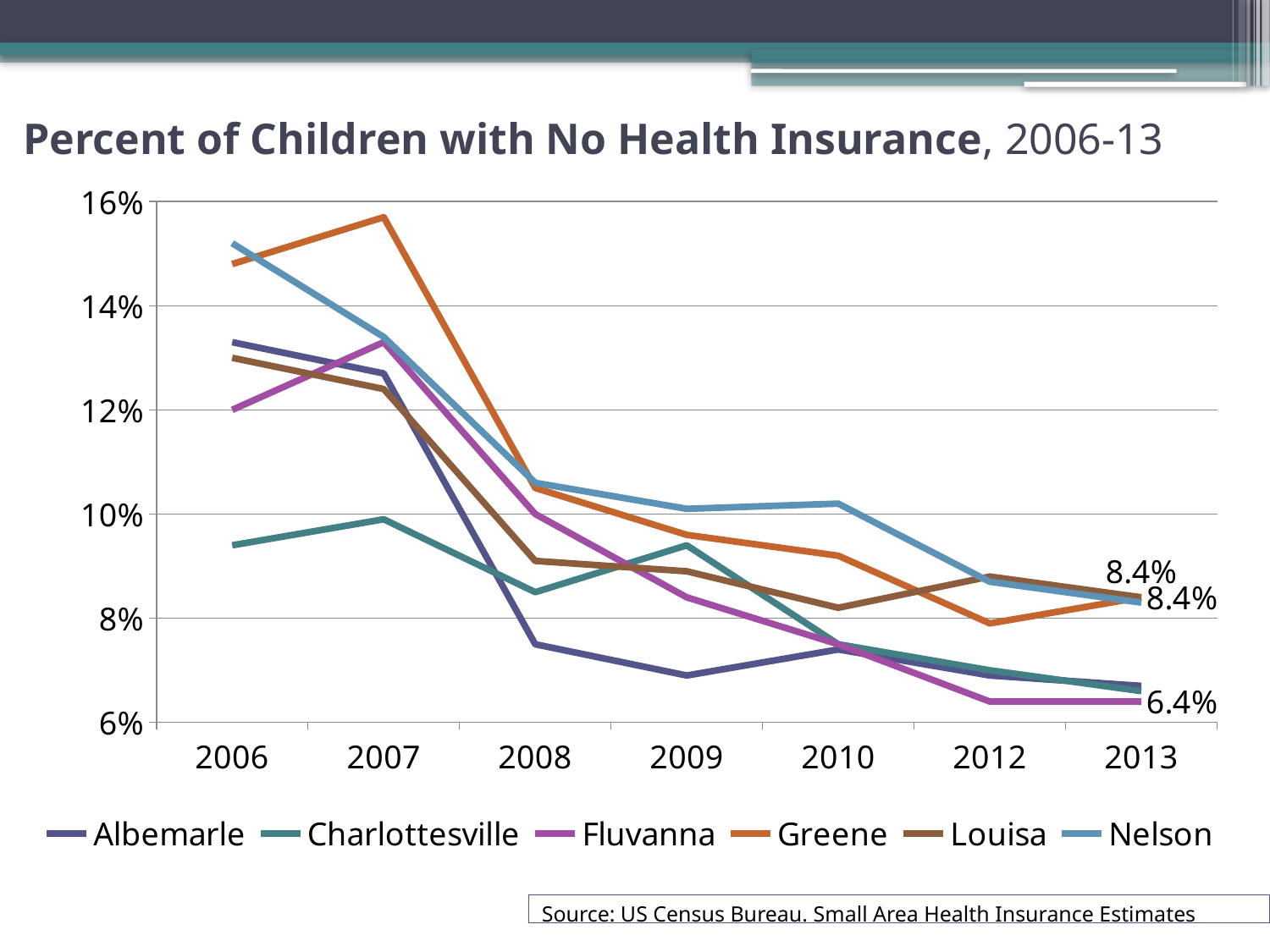
Is the value for Greene in 2006 greater or less than 14%? greater Does the Greene line rise or fall from 2007 to 2013? fall What kind of chart is shown on the slide? line chart Is the value for Albemarle in 2008 greater or less than 8%? less Which locality had the highest percentage of children with no health insurance in 2010? Nelson What is the value for Fluvanna in 2013? 6.4% In 2006, which is larger: the value for Nelson or the value for Fluvanna? Nelson Which locality had the lowest percentage of children with no health insurance in 2013? Fluvanna Which locality had the lowest percentage of children with no health insurance in 2006? Charlottesville How many years are shown along the x axis? 7 Which locality had the highest percentage of children with no health insurance in 2007? Greene How many series does the legend list? 6